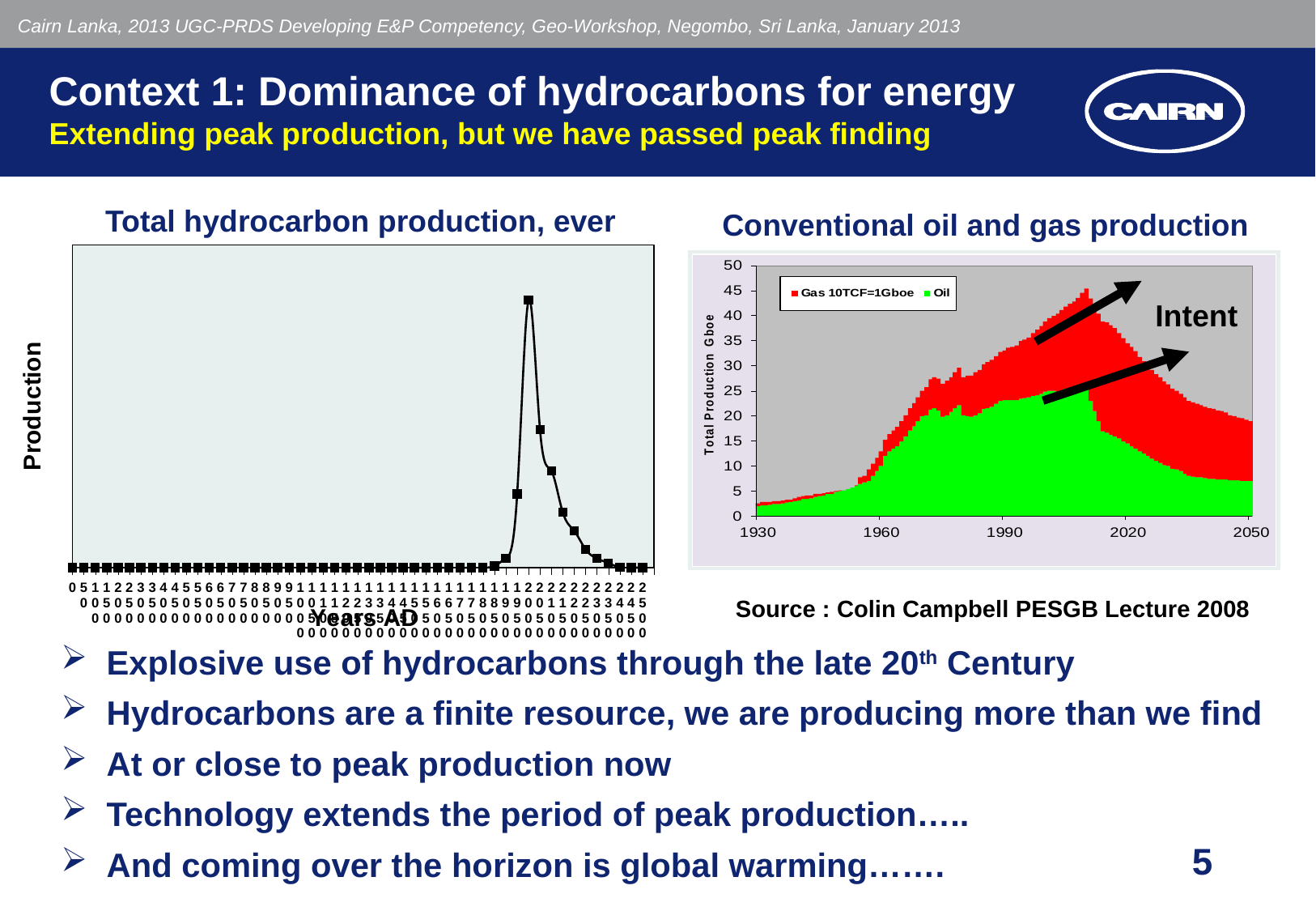
In the 'Conventional oil and gas production' chart, is oil production in 2050 greater or less than 10? less What kind of chart is the 'Conventional oil and gas production' chart on the right? Stacked area chart What are the two legend entries in the 'Conventional oil and gas production' chart? Gas 10TCF=1Gboe and Oil How many series does the legend of the 'Conventional oil and gas production' chart list? 2 In the 'Conventional oil and gas production' chart, which series is larger in 1960, Gas or Oil? Oil What is the y-axis title of the 'Conventional oil and gas production' chart? Total Production Gboe In the 'Conventional oil and gas production' chart, does total production rise or fall between 1930 and 2010? Rise In the 'Conventional oil and gas production' chart, is the total production in 1930 greater or less than 5? less What kind of chart is the 'Total hydrocarbon production, ever' chart on the left? Line chart In the 'Conventional oil and gas production' chart, which series is larger in 2050, Gas or Oil? Gas In the 'Conventional oil and gas production' chart, is the peak total production (around 2010) greater or less than 40? greater